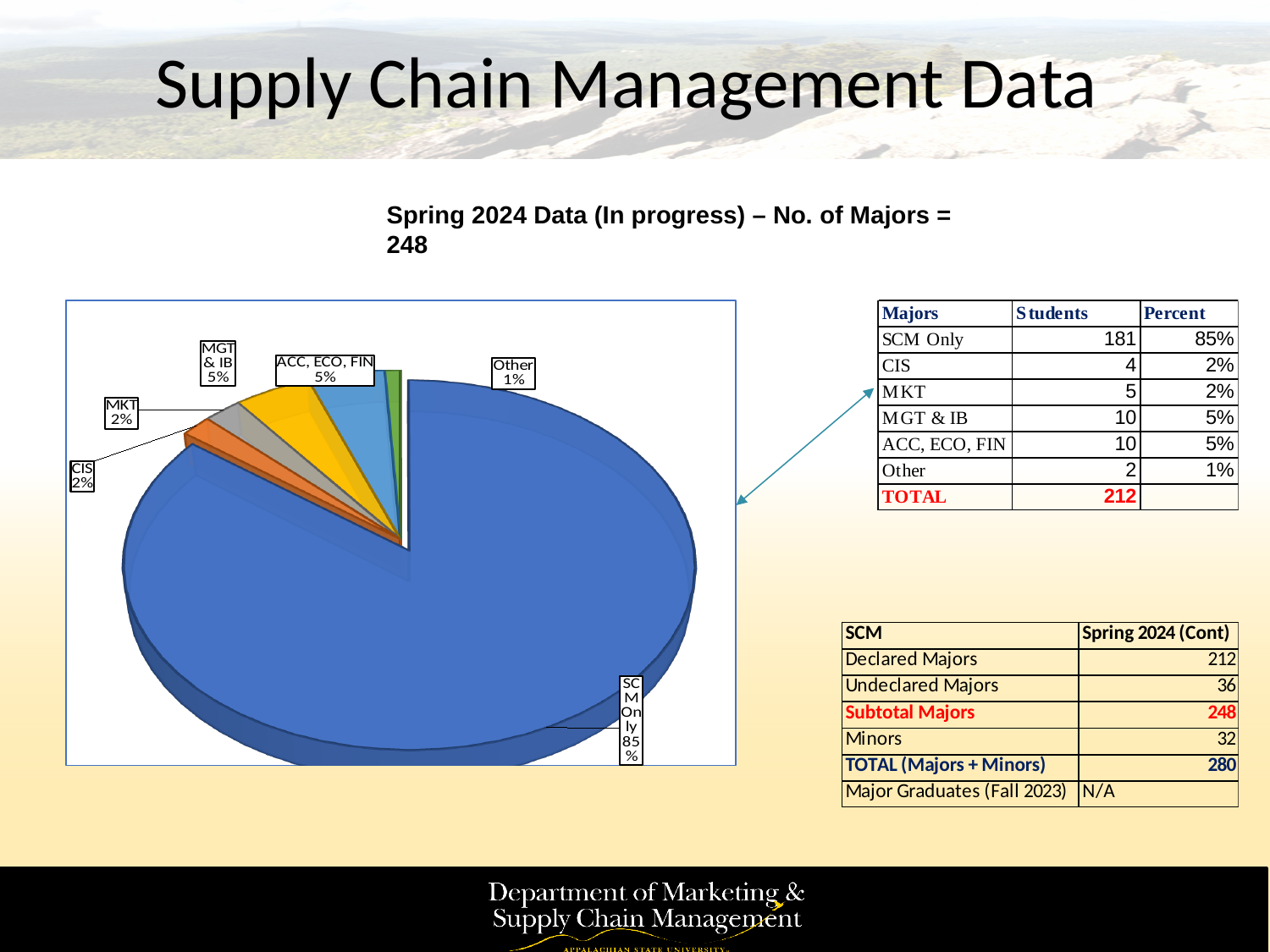
Which slice of the pie chart is the largest? SCM Only What kind of chart is shown on the slide? pie chart What percentage is shown for the MKT slice in the pie chart? 2% How many slices does the pie chart have? 6 What percentage is shown for the MGT & IB slice in the pie chart? 5% What percentage is shown for the ACC, ECO, FIN slice in the pie chart? 5% Which is larger in the pie chart, the MGT & IB slice or the CIS slice? MGT & IB What share of the pie does the SCM Only slice represent? 85% What percentage is shown for the Other slice in the pie chart? 1% What percentage is shown for the CIS slice in the pie chart? 2% Which slice of the pie chart is the smallest? Other What is the difference in percentage points between the SCM Only slice and the ACC, ECO, FIN slice? 80